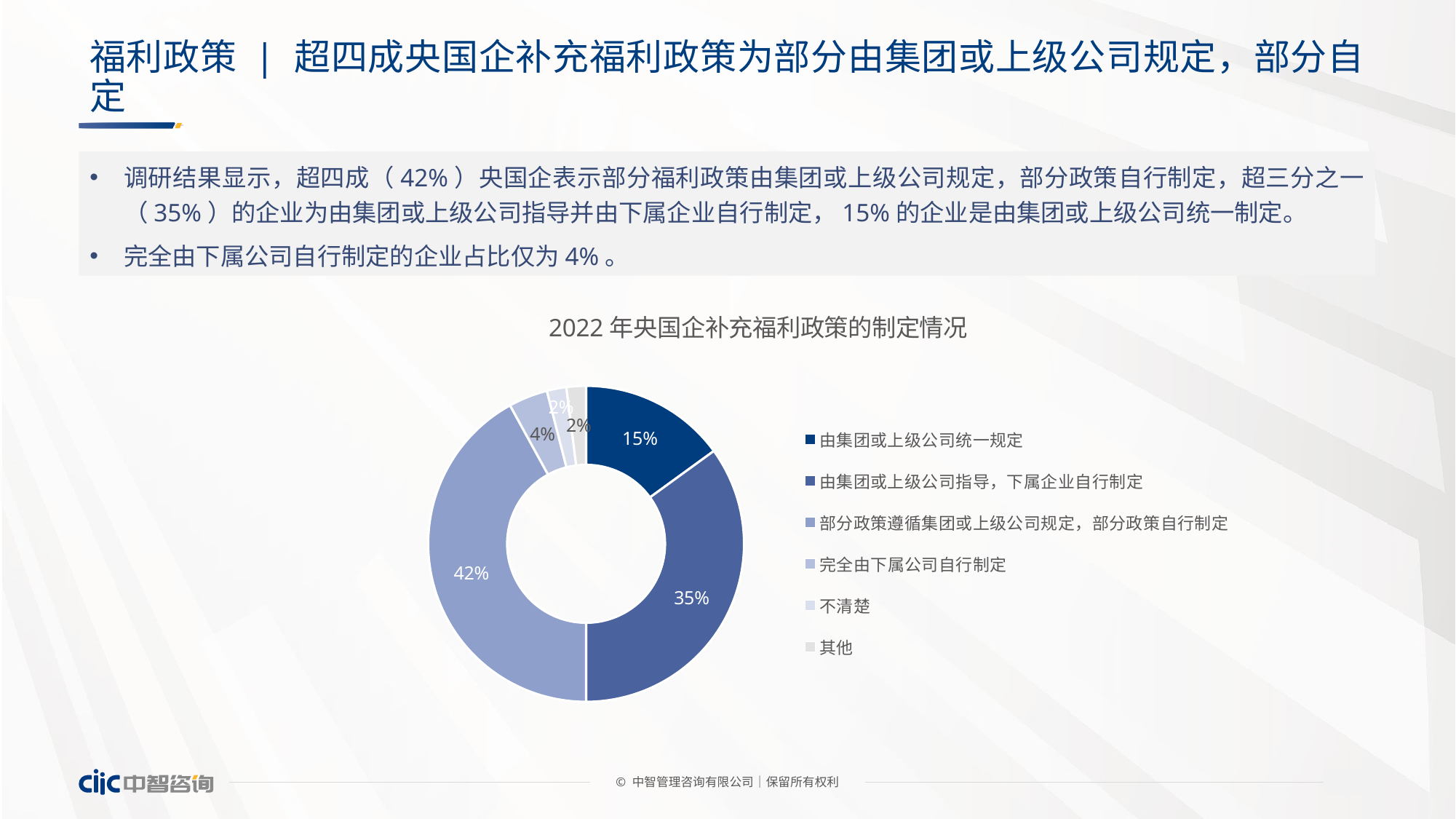
Which category has the largest share in the chart? 部分政策遵循集团或上级公司规定，部分政策自行制定 What share of the chart is labelled 由集团或上级公司统一规定? 15% Which is larger: the share for 由集团或上级公司统一规定 or the share for 完全由下属公司自行制定? 由集团或上级公司统一规定 What share of the chart is labelled 完全由下属公司自行制定? 4% What type of chart is shown on the slide? Pie (donut) chart What share of the chart is labelled 部分政策遵循集团或上级公司规定，部分政策自行制定? 42% What share of the chart is labelled 不清楚? 2% What is the difference between the share for 部分政策遵循集团或上级公司规定，部分政策自行制定 and the share for 由集团或上级公司指导，下属企业自行制定? 7% How many categories does the legend list? 6 What is the combined share of 由集团或上级公司统一规定 and 由集团或上级公司指导，下属企业自行制定? 50% What share of the chart is labelled 由集团或上级公司指导，下属企业自行制定? 35% What is the title of the chart? 2022 年央国企补充福利政策的制定情况